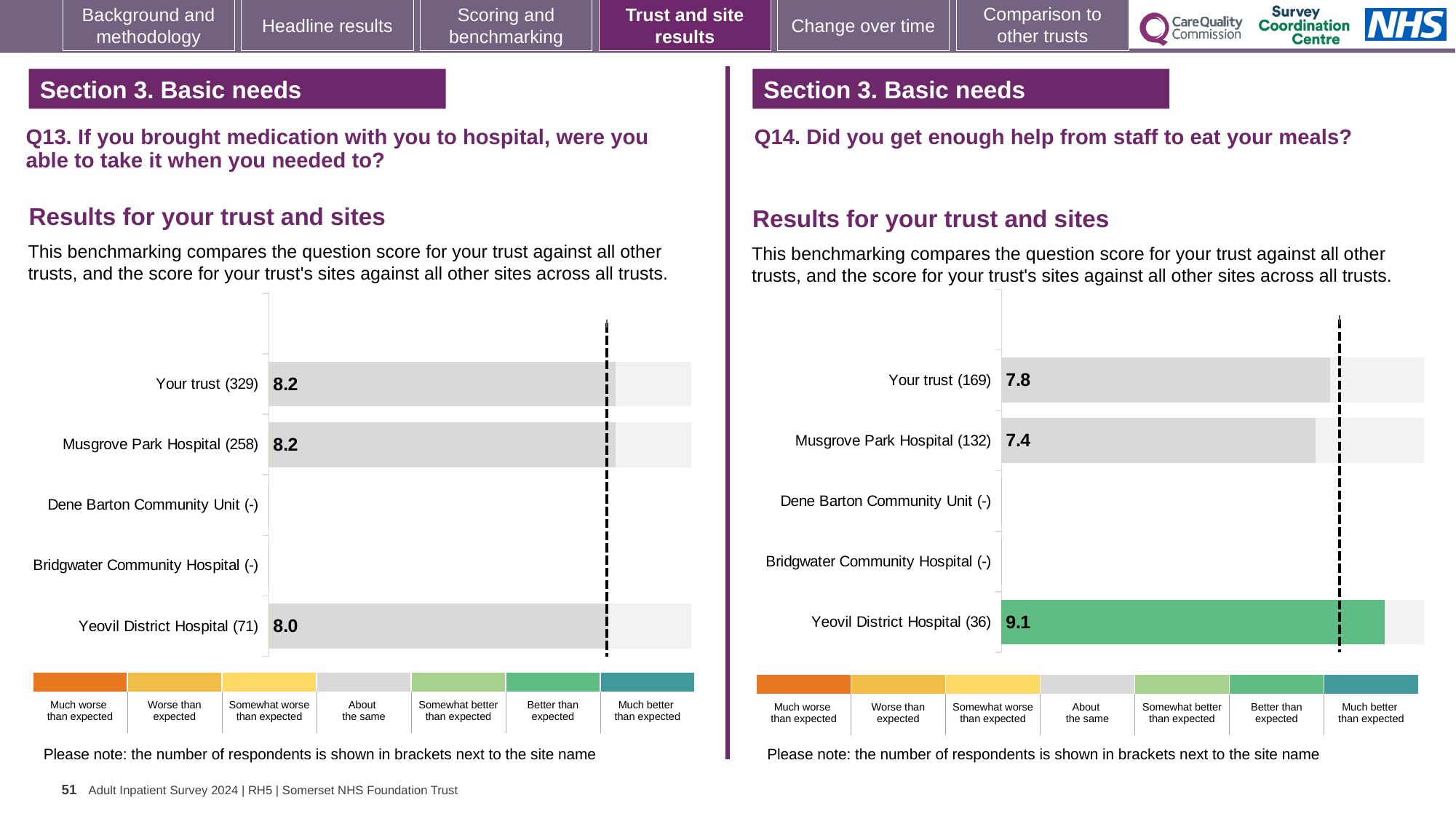
In the Q14 chart on the right, which has the larger score: Your trust (169) or Musgrove Park Hospital (132)? Your trust (169) In the Q14 chart on the right, what is the difference between the scores for Yeovil District Hospital (36) and Your trust (169)? 1.3 In the Q14 chart on the right, what is the score for Musgrove Park Hospital (132)? 7.4 In the Q13 chart on the left, what is the difference between the scores for Musgrove Park Hospital (258) and Yeovil District Hospital (71)? 0.2 In the Q14 chart on the right, which site or trust has the lowest score among those with a value shown? Musgrove Park Hospital (132) In the Q14 chart on the right, which site or trust has the highest score? Yeovil District Hospital (36) In the Q13 chart on the left, what is the score for Your trust (329)? 8.2 In the Q14 chart on the right, which benchmark category does the green bar for Yeovil District Hospital (36) correspond to in the colour key? Better than expected In the Q14 chart on the right, what is the score for Yeovil District Hospital (36)? 9.1 In the Q13 chart on the left, what is the score for Yeovil District Hospital (71)? 8.0 What kind of chart is used in the Q14 chart on the right? Bar chart How many categories (trust and sites) are listed on the y axis of the Q13 chart on the left? 5